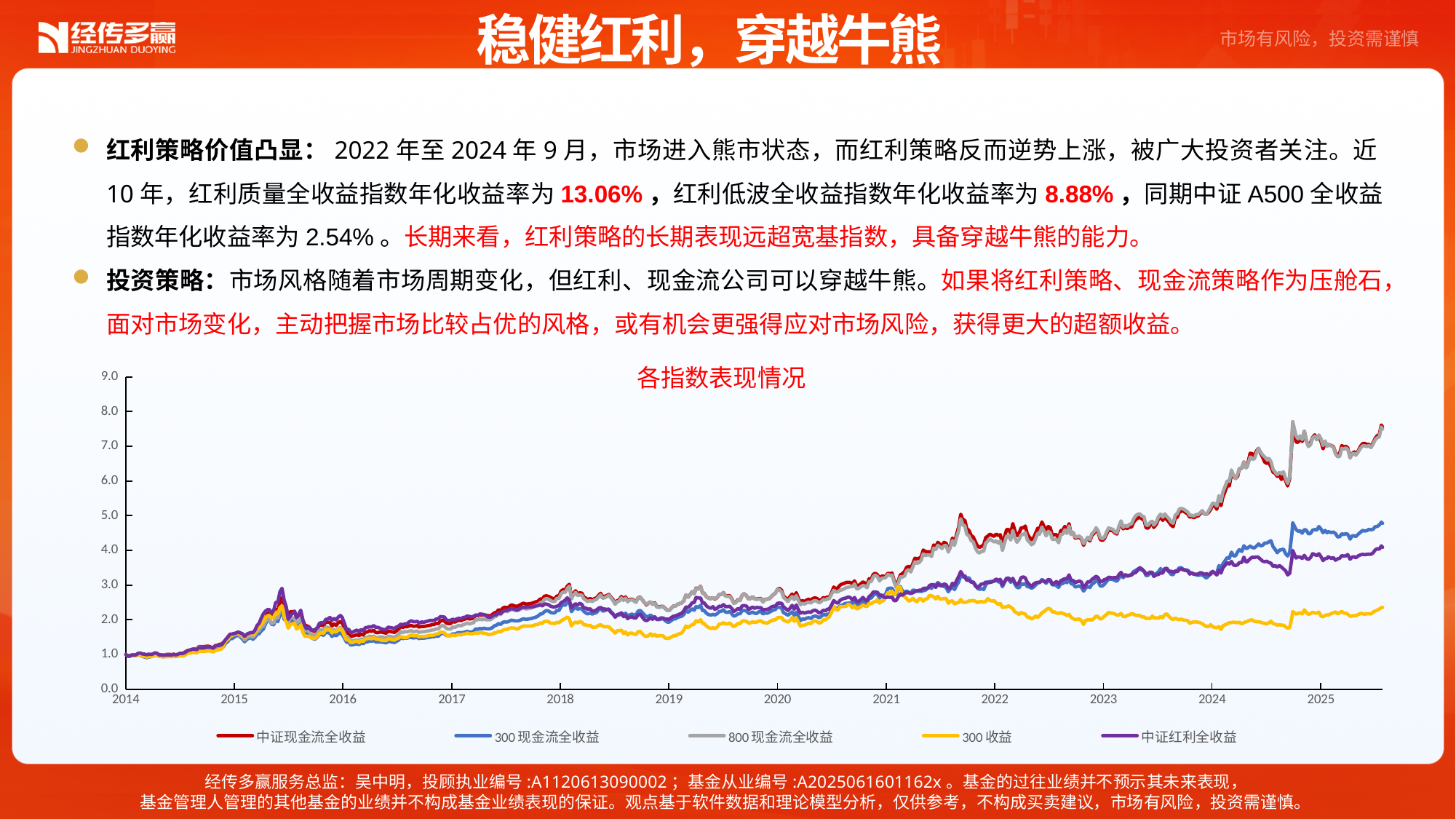
At the end of 2025, which is larger: 300现金流全收益 or 中证红利全收益? 300现金流全收益 How many series does the legend of the chart list? 5 What colour is the line for 300收益? yellow Is the value of 300收益 at the end of 2025 greater or less than 3.0? less Which series has the lowest value at the end of 2025? 300收益 What type of chart is shown on the slide? line chart How many year labels are shown on the x axis? 12 Does 中证现金流全收益 rise or fall overall from 2014 to 2025? rise Is the value of 中证现金流全收益 at the end of 2025 greater or less than 7.0? greater Is the value of 300现金流全收益 at the end of 2025 greater or less than 4.0? greater What is the title of the chart? 各指数表现情况